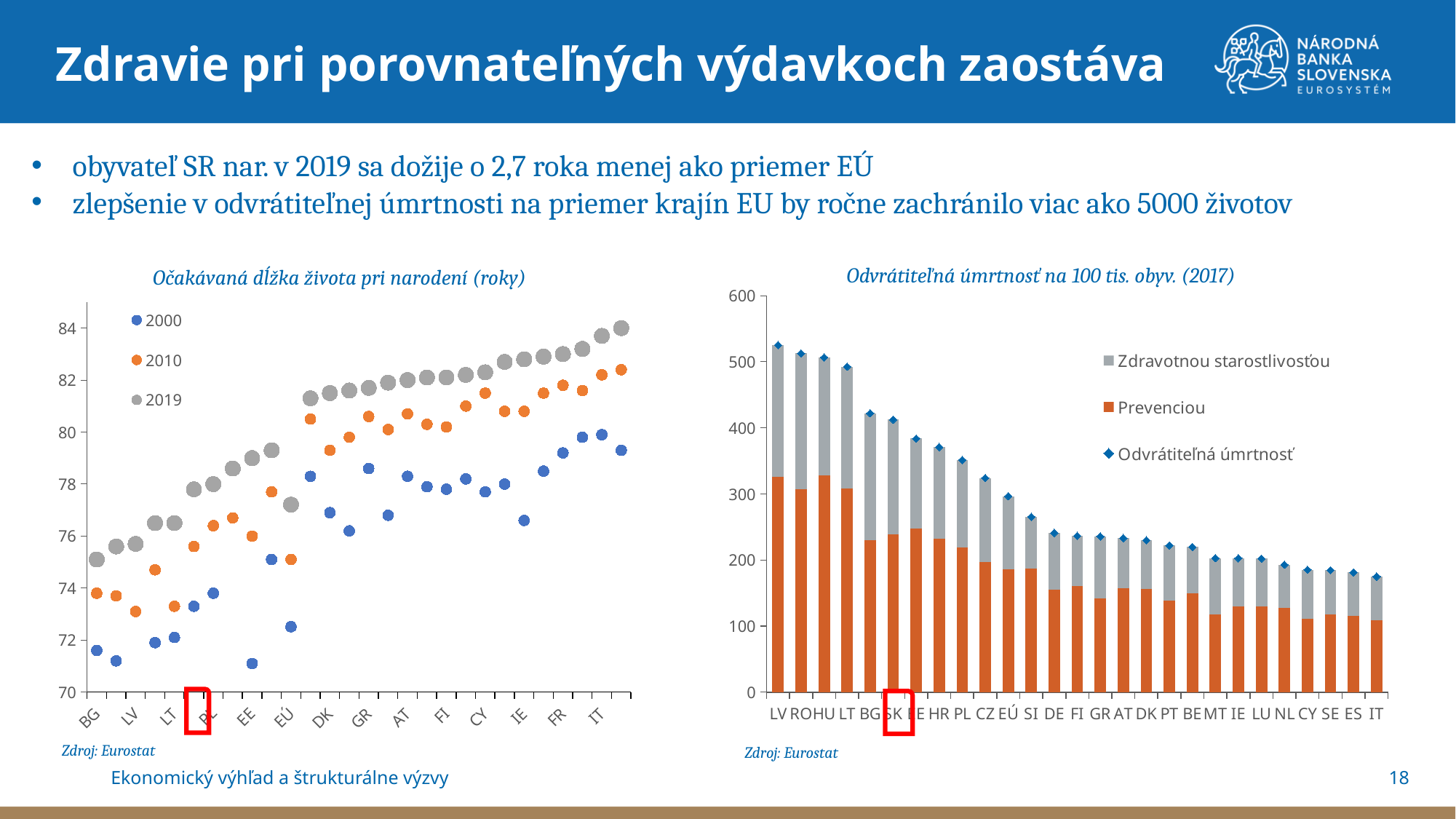
How many countries are shown on the x axis of the 'Odvrátiteľná úmrtnosť na 100 tis. obyv. (2017)' chart? 27 What kind of chart is the 'Odvrátiteľná úmrtnosť na 100 tis. obyv. (2017)' chart? Stacked bar chart In the 'Odvrátiteľná úmrtnosť na 100 tis. obyv. (2017)' chart, which country has the highest total? LV In the 'Očakávaná dĺžka života pri narodení (roky)' chart, is the 2019 value for IT greater or less than 82? greater How many series does the legend of the 'Očakávaná dĺžka života pri narodení (roky)' chart list? 3 In the 'Očakávaná dĺžka života pri narodení (roky)' chart, which country has the larger 2019 value, BG or IT? IT In the 'Odvrátiteľná úmrtnosť na 100 tis. obyv. (2017)' chart, which has the larger total, SK or EÚ? SK In the 'Odvrátiteľná úmrtnosť na 100 tis. obyv. (2017)' chart, is the total for IT greater or less than 200? less In the 'Odvrátiteľná úmrtnosť na 100 tis. obyv. (2017)' chart, is the total for EÚ greater or less than 400? less How many series does the legend of the 'Odvrátiteľná úmrtnosť na 100 tis. obyv. (2017)' chart list? 3 In the 'Odvrátiteľná úmrtnosť na 100 tis. obyv. (2017)' chart, do the totals rise or fall from left to right along the x axis? fall